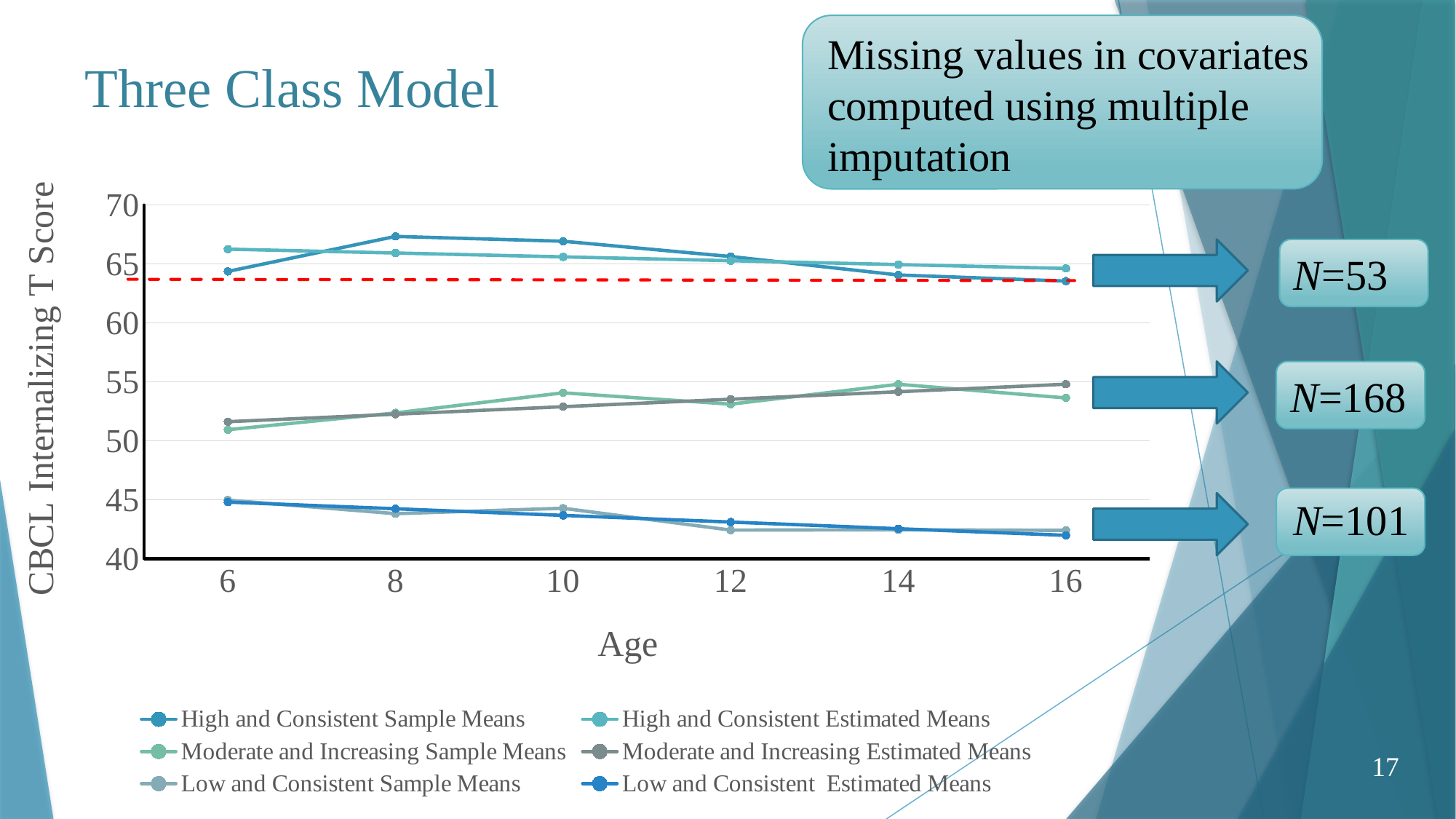
Do the values for Low and Consistent Estimated Means rise or fall from age 6 to age 16? fall Is the value for Low and Consistent Estimated Means at age 16 greater or less than 45? less At age 8, which is larger: High and Consistent Sample Means or Moderate and Increasing Sample Means? High and Consistent Sample Means How many series does the legend list? 6 Is the value for Moderate and Increasing Sample Means at age 6 greater or less than 55? less Is the value for High and Consistent Sample Means at age 8 greater or less than 65? greater What is the title of the y axis? CBCL Internalizing T Score What kind of chart is shown on the slide? line chart What is the title of the x axis? Age How many age points are plotted along the x axis? 6 Do the values for Moderate and Increasing Estimated Means rise or fall from age 6 to age 16? rise